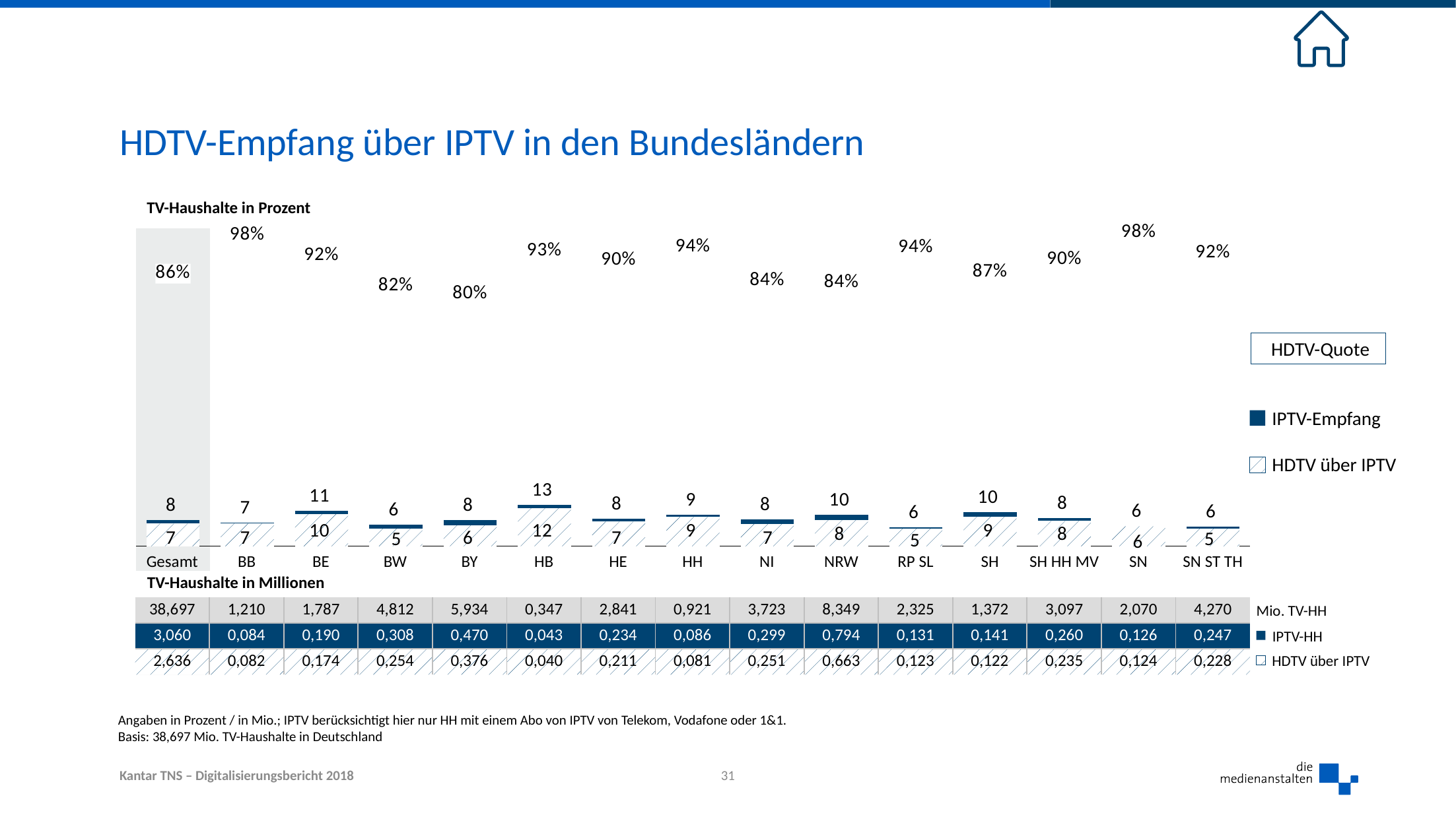
What is the HDTV über IPTV value (TV-Haushalte in Prozent) for NRW? 8 Which Bundesland has the highest IPTV-Empfang value in percent? HB Which has a higher HDTV-Quote, HH or NI? HH What kind of chart is shown on the slide? bar chart What is the HDTV-Quote for Gesamt? 86% How many categories are shown on the x axis of the chart? 15 What is the IPTV-Empfang value (TV-Haushalte in Prozent) for HB? 13 What is the difference between the IPTV-Empfang and HDTV über IPTV percentages for BE? 1 What is the HDTV-Quote for BY? 80% What is the Mio. TV-HH value for NRW in the table below the chart? 8,349 Which category has the lowest HDTV-Quote? BY What is the difference between the HDTV-Quote of BB and the HDTV-Quote of BW? 16%